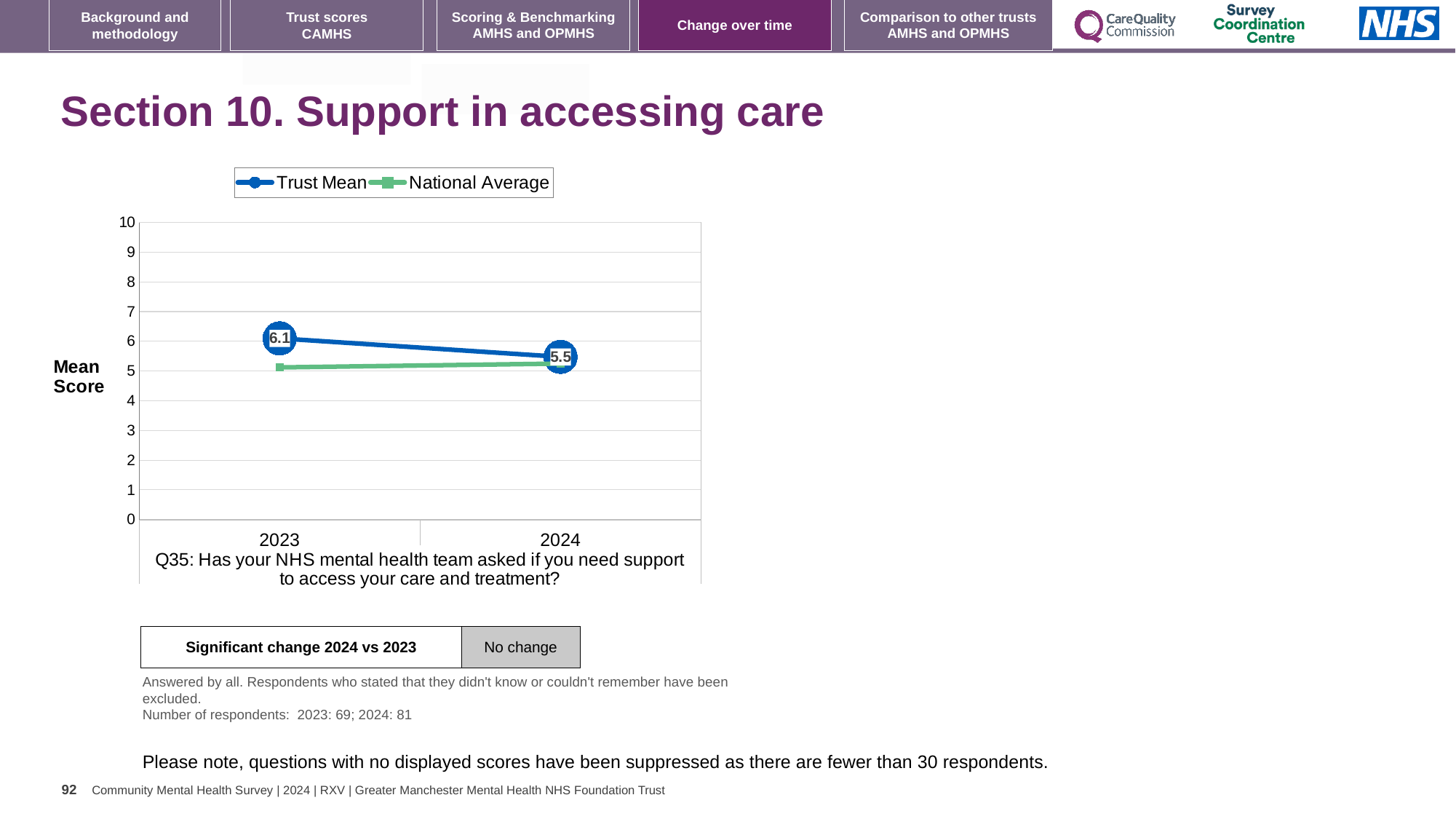
Is the National Average value for 2023 greater or less than 6? less Does the Trust Mean rise or fall from 2023 to 2024? fall Is the National Average value for 2024 greater or less than 6? less How many years are shown on the x axis? 2 What is the Trust Mean value for 2023? 6.1 What kind of chart is shown on the slide? line chart In 2023, which is larger: the Trust Mean or the National Average? Trust Mean In which year is the Trust Mean lowest? 2024 How many series does the legend list? 2 What is the difference between the Trust Mean in 2023 and in 2024? 0.6 What is the Trust Mean value for 2024? 5.5 In which year is the Trust Mean highest? 2023